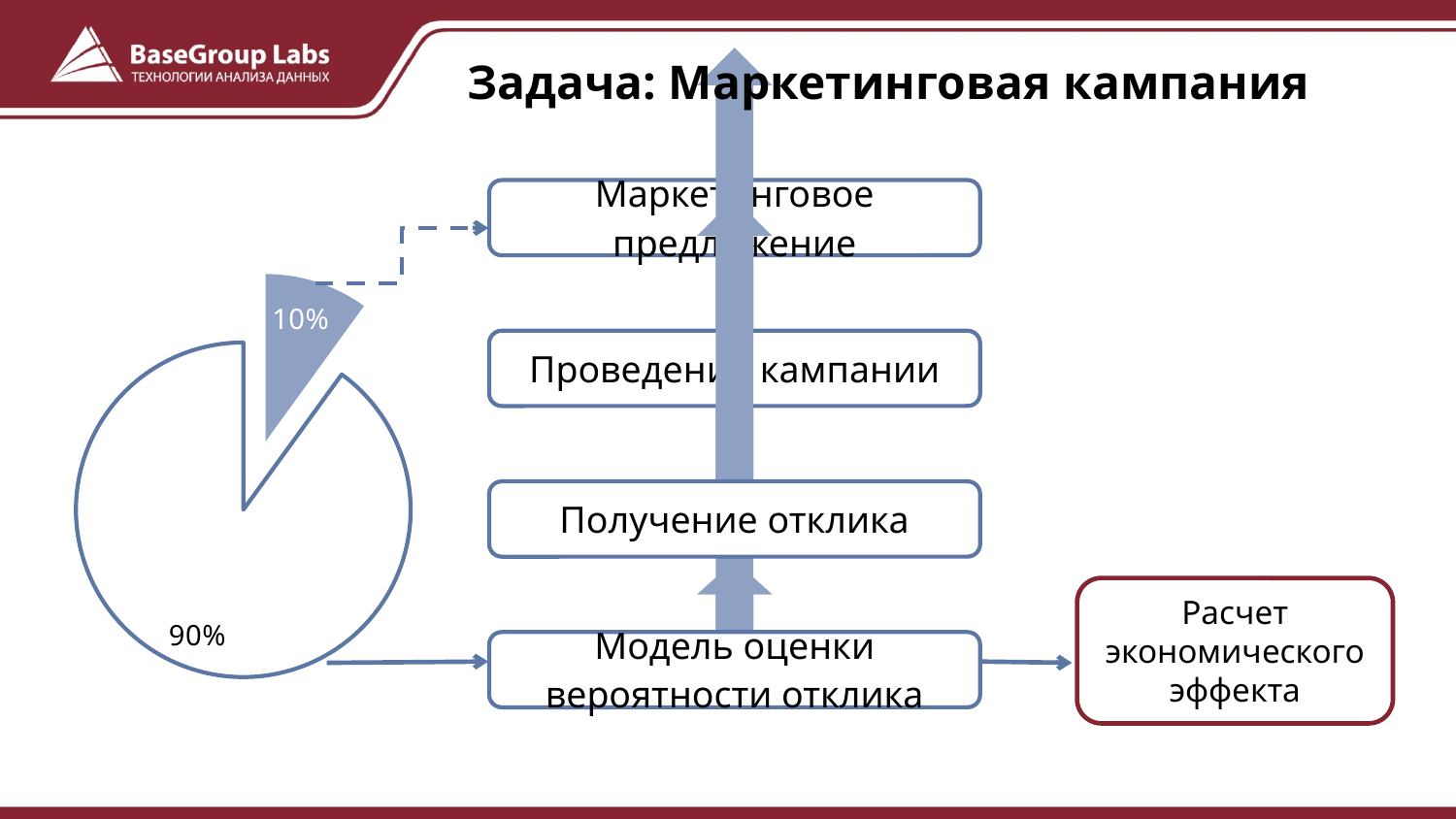
Is the value of the blue slice of the pie chart greater or less than 50%? less What percentage is shown on the white slice of the pie chart? 90% Which box does the dashed arrow from the 10% slice point to? Маркетинговое предложение What is the value of the smallest slice of the pie chart? 10% What is the value of the largest slice of the pie chart? 90% How many slices does the pie chart have? 2 Does the pie chart have a legend? No What is the difference between the two slices of the pie chart? 80% What share of the pie does the blue slice represent? 10% What percentage is shown on the exploded (pulled-out) slice of the pie chart? 10% What kind of chart is shown on the left of the slide? pie chart Which slice of the pie chart is larger, the blue one or the white one? the white one